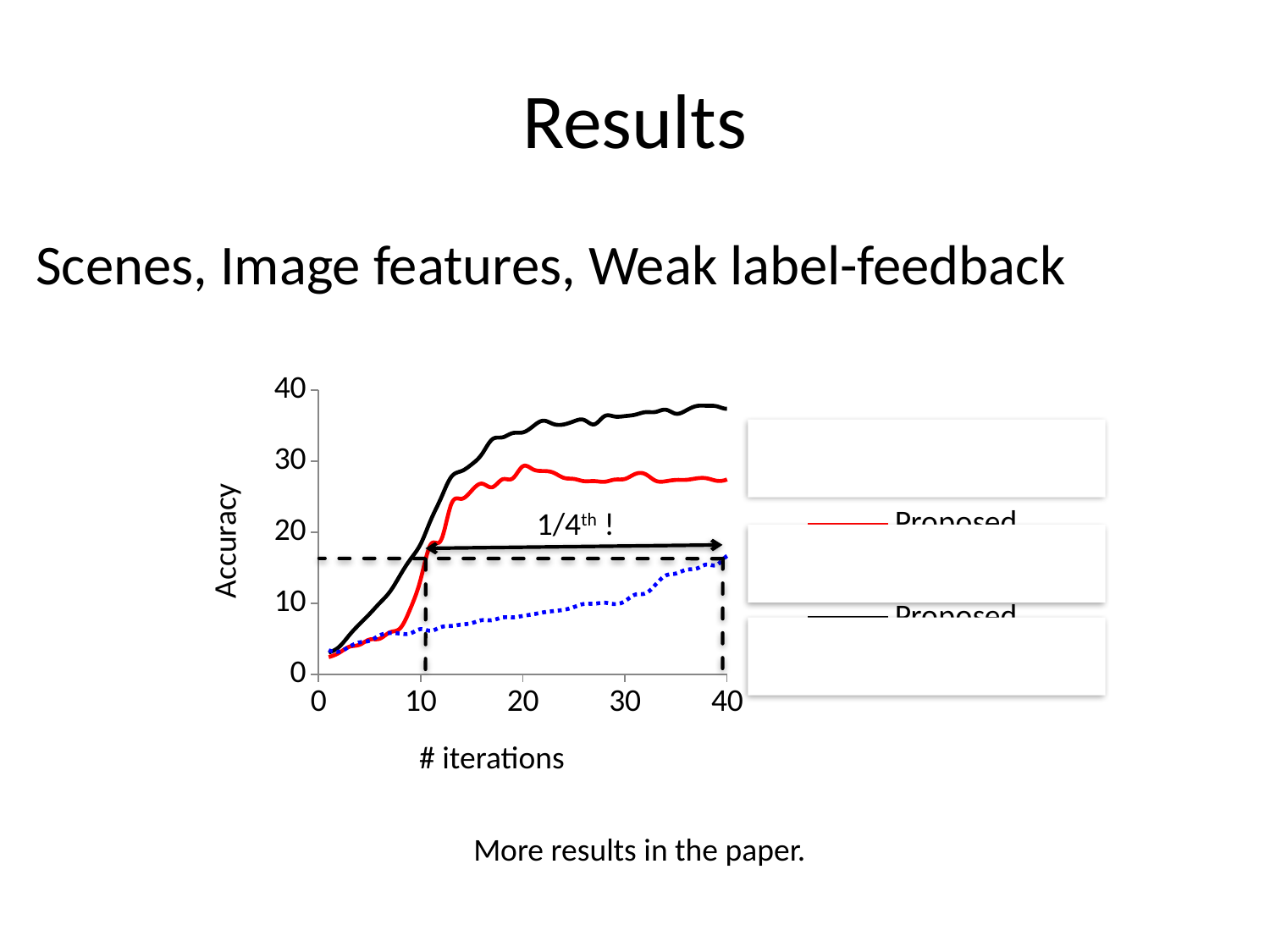
Which line has the lowest accuracy at 40 iterations: the black solid line, the red solid line, or the blue dotted line? the blue dotted line Does the blue dotted line generally rise or fall as the number of iterations increases? rise Is the accuracy of the blue dotted line at 40 iterations greater or less than 20? less Which line reaches the highest accuracy at 40 iterations: the black solid line, the red solid line, or the blue dotted line? the black solid line What kind of chart is shown on the slide? line chart Is the accuracy of the red solid line at 40 iterations greater or less than 30? less What is the label of the y axis? Accuracy At 30 iterations, which has higher accuracy: the red solid line or the blue dotted line? the red solid line Is the accuracy of the blue dotted line at 20 iterations greater or less than 10? less How many lines are plotted on the chart? 3 What is the label of the x axis? # iterations